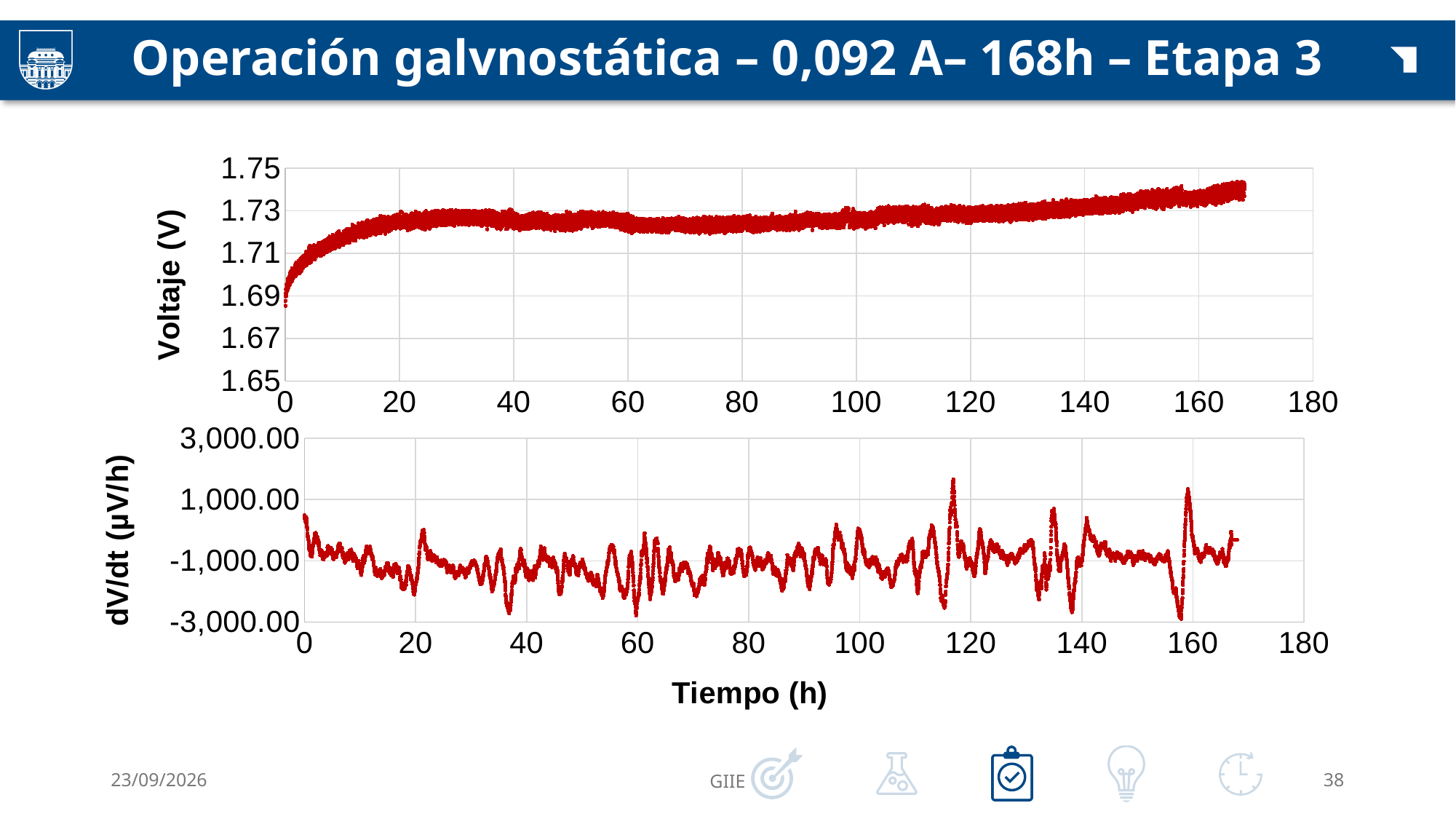
In the top chart, is the voltage at 0 h greater or less than 1.71? less What is the y-axis label of the top chart? Voltaje (V) What kind of chart is the top chart (Voltaje vs Tiempo)? line chart In the bottom chart, is the dV/dt value at 100 h greater or less than 1,000.00? less What is the y-axis label of the bottom chart? dV/dt (µV/h) In the top chart, is the voltage at 20 h greater or less than 1.71? greater In the top chart, does the voltage generally rise or fall as time increases from 0 to 168 h? rise